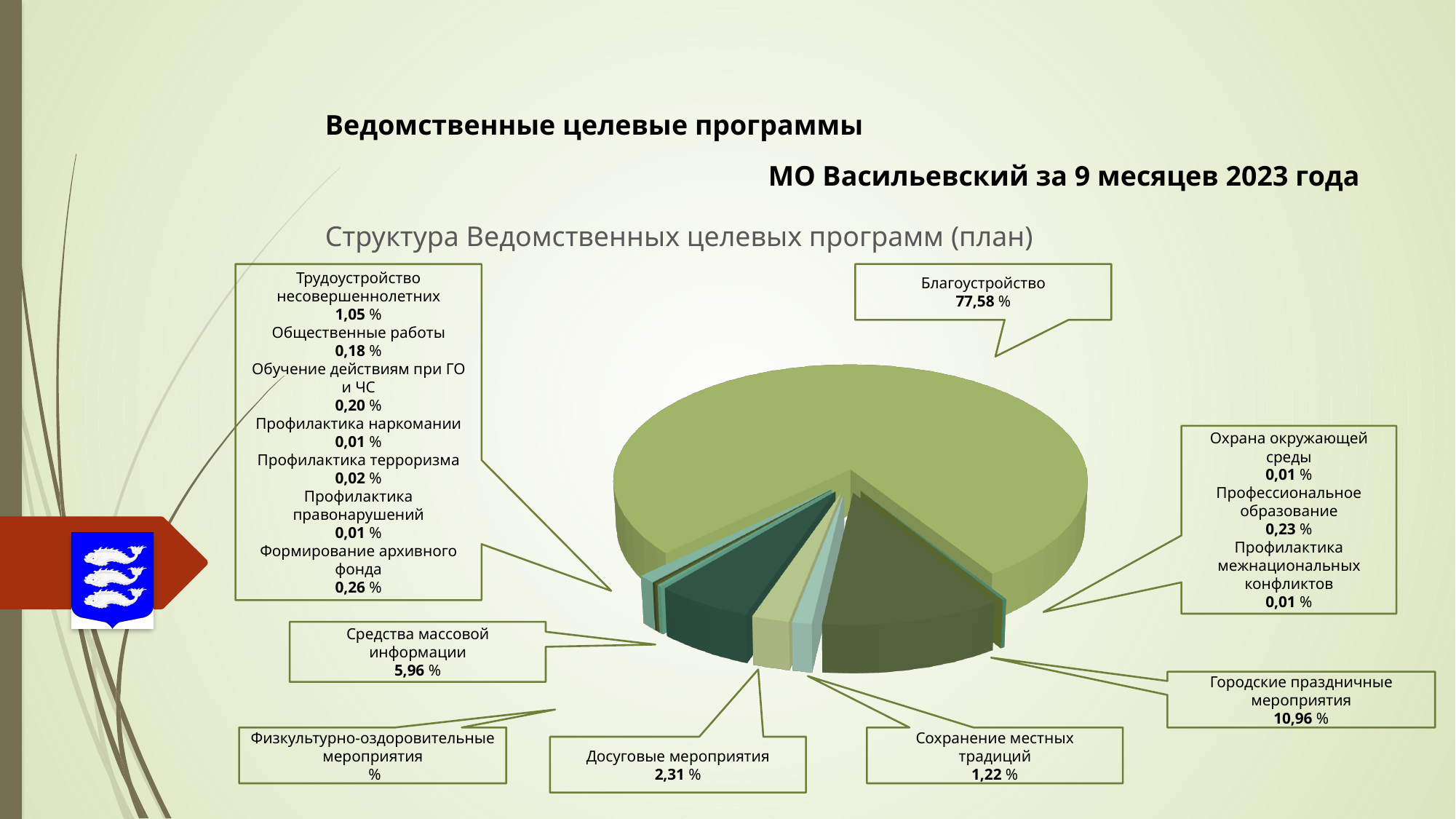
What is the value for Городские праздничные мероприятия? 10,96 % Which is larger: Средства массовой информации or Досуговые мероприятия? Средства массовой информации What is the value for Средства массовой информации? 5,96 % What type of chart is shown on the slide? pie chart What is the value for Сохранение местных традиций? 1,22 % What is the difference between the shares of Благоустройство and Городские праздничные мероприятия? 66,62 % What is the value for Формирование архивного фонда? 0,26 % What is the value for Трудоустройство несовершеннолетних? 1,05 % Which category has the largest share of the pie? Благоустройство What is the title of the chart? Структура Ведомственных целевых программ (план) What share does Благоустройство have in the pie chart? 77,58 % What is the value for Досуговые мероприятия? 2,31 %